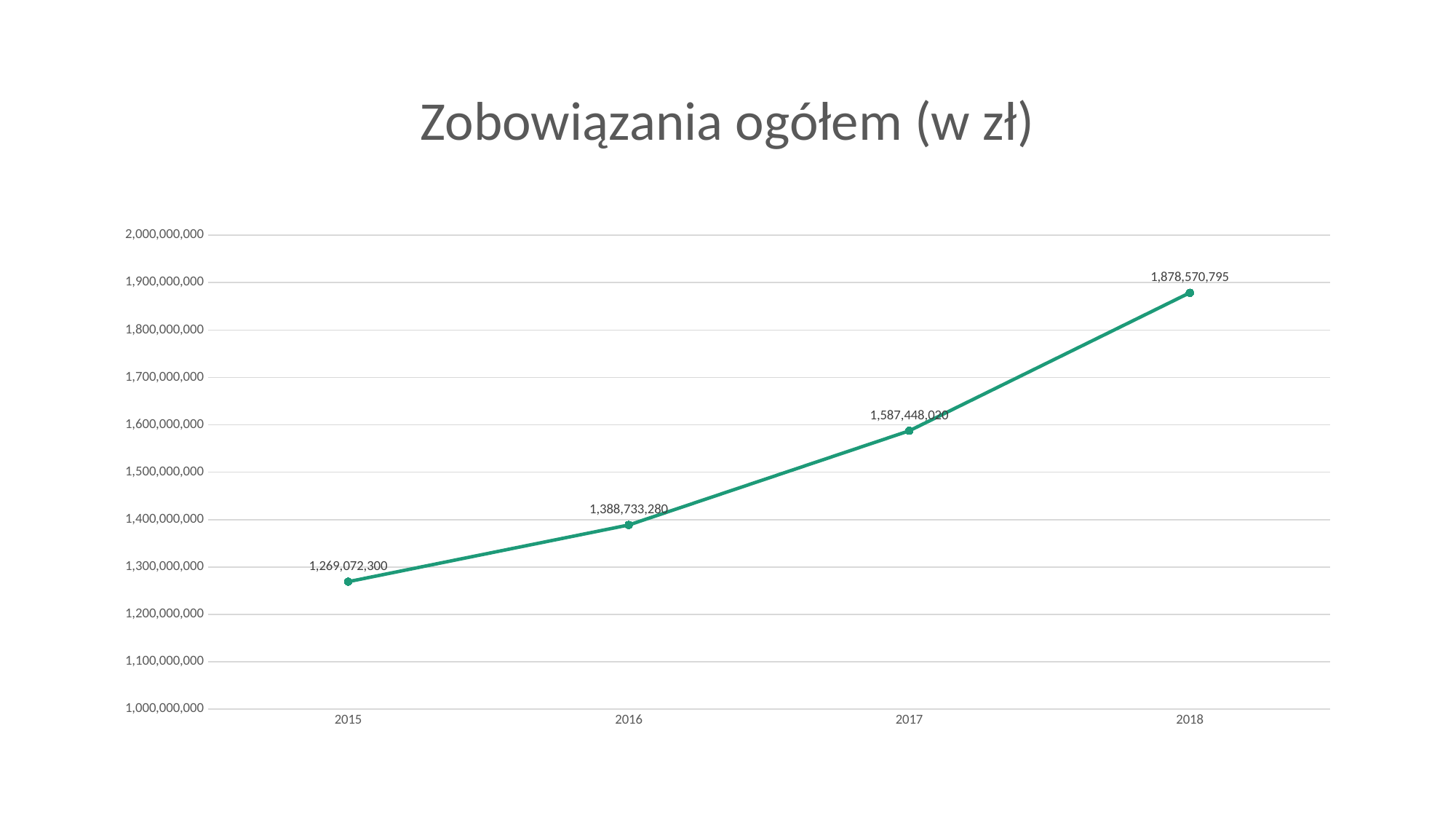
What is the value for 2018? 1,878,570,795 Which year has the highest value? 2018 Which is larger, the value for 2017 or the value for 2016? 2017 Do the values rise or fall from 2015 to 2018? rise What is the value for 2016? 1,388,733,280 What is the difference between the values for 2016 and 2015? 119,660,980 Is the value for 2017 greater or less than 1,500,000,000? greater What is the difference between the values for 2018 and 2017? 291,122,775 What is the value for 2015? 1,269,072,300 Which year has the lowest value? 2015 How many years are plotted on the chart? 4 What kind of chart is shown? line chart